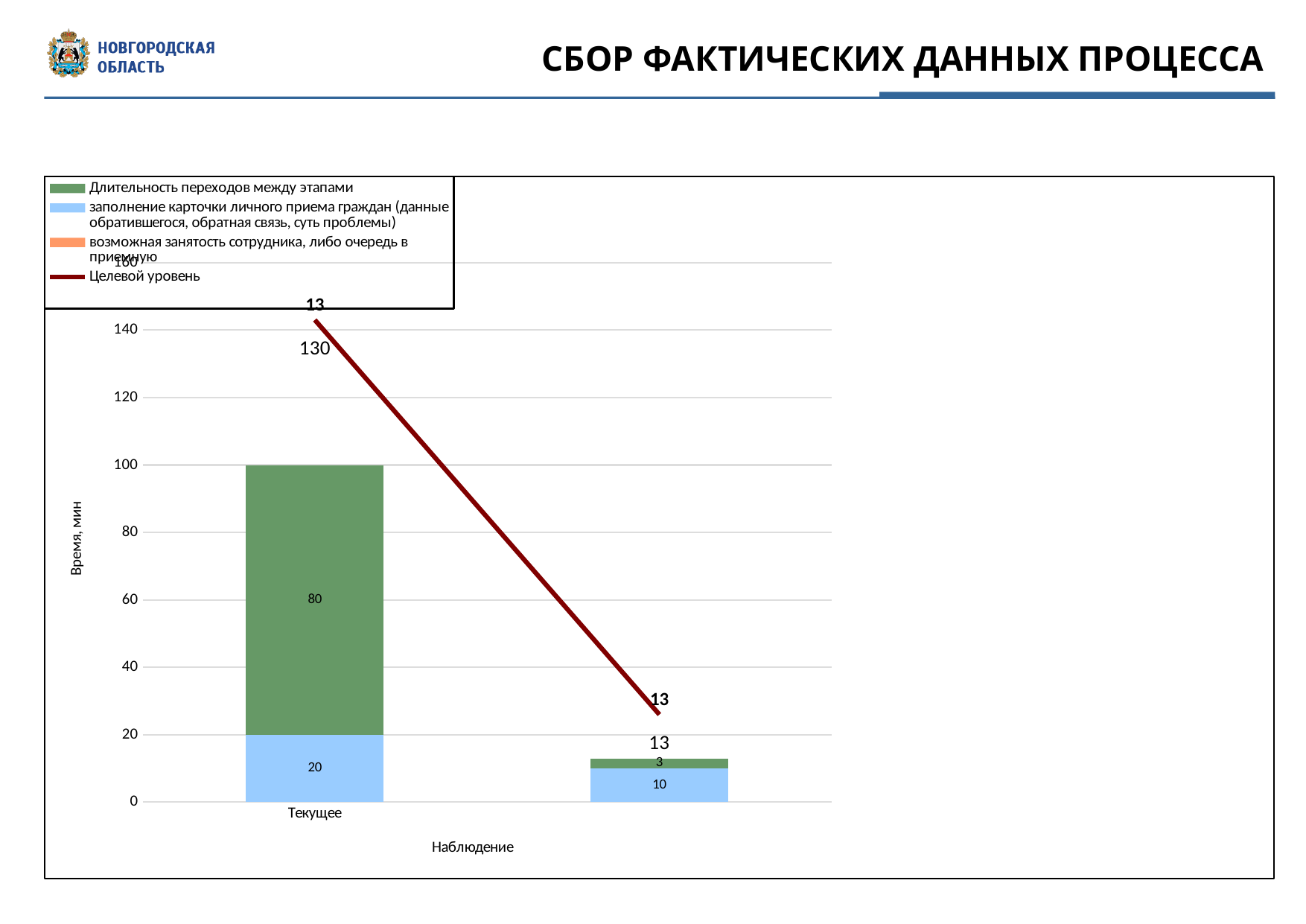
What is the difference between the green segment (80) and the blue segment (20) in the 'Текущее' bar? 60 Does the 'Целевой уровень' line rise or fall from left to right? falls In the 'Текущее' bar, which segment is larger: 'Длительность переходов между этапами' or 'заполнение карточки личного приема граждан'? Длительность переходов между этапами What kind of chart is shown on the slide? combination bar and line chart How many bars are plotted on the chart? 2 What is the total height of the stacked bar for 'Текущее'? 100 What is the value of the 'заполнение карточки личного приема граждан' segment for 'Текущее'? 20 How many entries does the legend list? 4 What is the title of the vertical axis? Время, мин Is the total of the 'Текущее' bar greater or less than 80? greater What is the value of the 'Длительность переходов между этапами' segment for 'Текущее'? 80 What is the title of the horizontal axis? Наблюдение